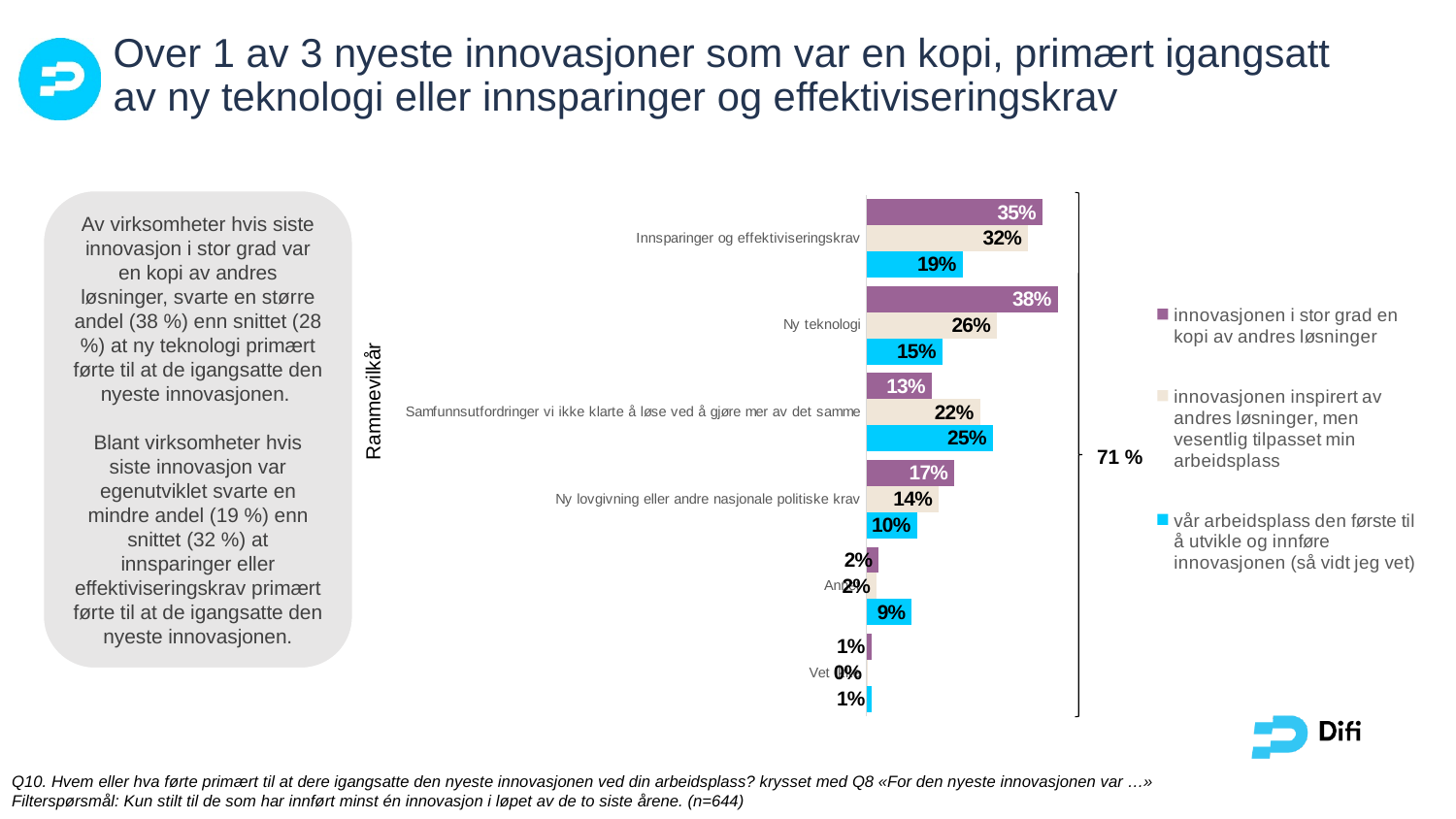
What is the value for 'Ny teknologi' in the series 'innovasjonen i stor grad en kopi av andres løsninger'? 38% Which category has the highest value in the series 'innovasjonen i stor grad en kopi av andres løsninger'? Ny teknologi What is the value for 'Ny lovgivning eller andre nasjonale politiske krav' in the series 'innovasjonen i stor grad en kopi av andres løsninger'? 17% Which category has the highest value in the series 'vår arbeidsplass den første til å utvikle og innføre innovasjonen (så vidt jeg vet)'? Samfunnsutfordringer vi ikke klarte å løse ved å gjøre mer av det samme What is the label on the vertical axis of the chart? Rammevilkår What is the difference between the 'innovasjonen inspirert av andres løsninger, men vesentlig tilpasset min arbeidsplass' value and the 'innovasjonen i stor grad en kopi av andres løsninger' value for 'Samfunnsutfordringer vi ikke klarte å løse ved å gjøre mer av det samme'? 9% What is the value for 'Samfunnsutfordringer vi ikke klarte å løse ved å gjøre mer av det samme' in the series 'innovasjonen inspirert av andres løsninger, men vesentlig tilpasset min arbeidsplass'? 22% What kind of chart is shown on the slide? bar chart What is the value for 'Innsparinger og effektiviseringskrav' in the series 'vår arbeidsplass den første til å utvikle og innføre innovasjonen (så vidt jeg vet)'? 19% For 'Innsparinger og effektiviseringskrav', which series has the larger value: 'innovasjonen i stor grad en kopi av andres løsninger' or 'innovasjonen inspirert av andres løsninger, men vesentlig tilpasset min arbeidsplass'? innovasjonen i stor grad en kopi av andres løsninger How many series does the legend list? 3 What is the difference between the 'innovasjonen i stor grad en kopi av andres løsninger' value and the 'vår arbeidsplass den første til å utvikle og innføre innovasjonen (så vidt jeg vet)' value for 'Ny teknologi'? 23%